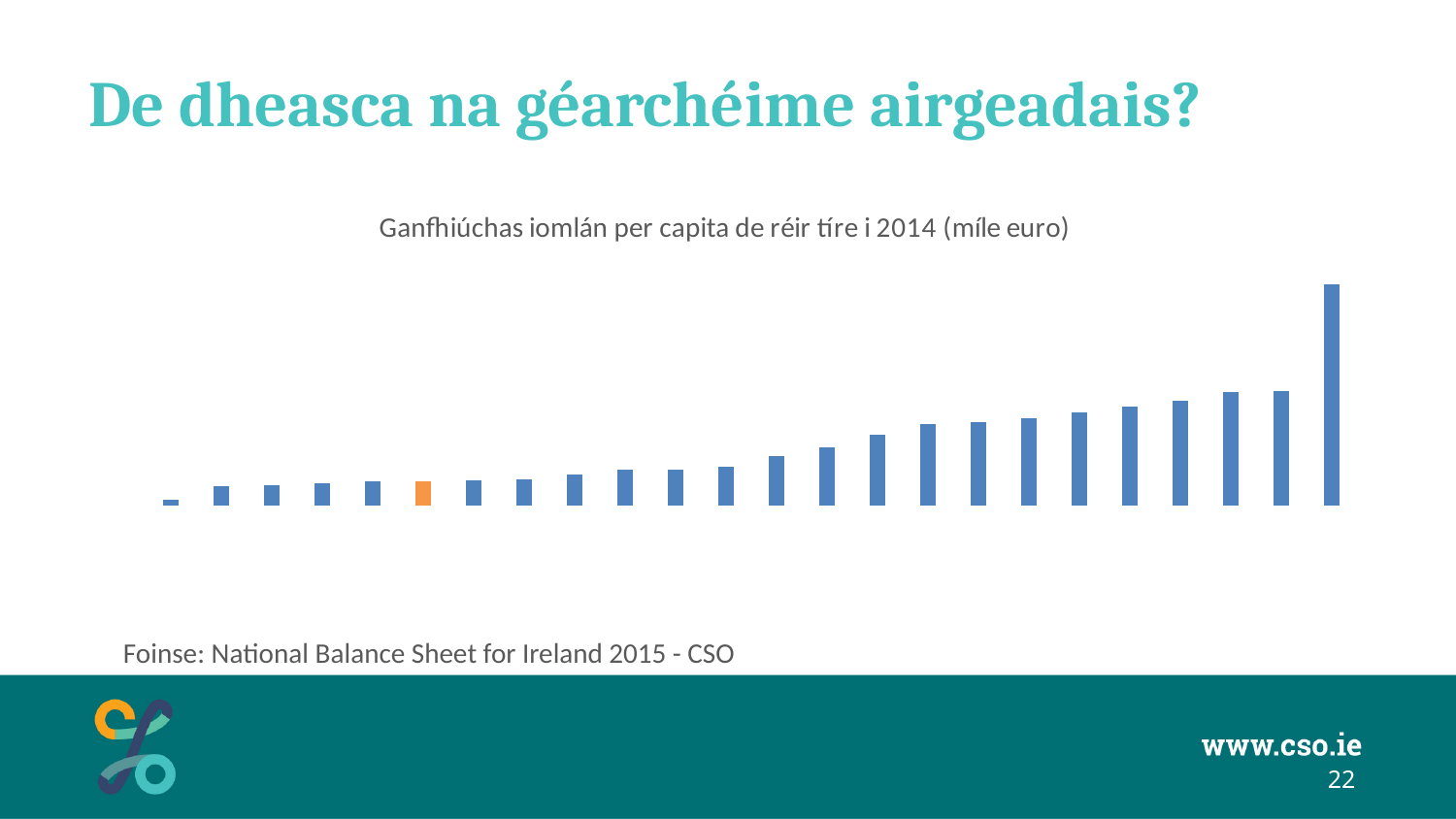
How many bars are plotted in the chart? 24 Is the orange bar taller or shorter than the rightmost bar? shorter Is the rightmost bar taller or shorter than the bar immediately to its left? taller Do the bar values rise or fall from left to right across the chart? rise Which bar is the tallest in the chart: the leftmost or the rightmost? the rightmost Which bar is the shortest in the chart: the leftmost or the rightmost? the leftmost What colour is the single highlighted bar that differs from the others? orange What kind of chart is shown on the slide? bar chart What is the title of the chart? Ganfhiúchas iomlán per capita de réir tíre i 2014 (míle euro)